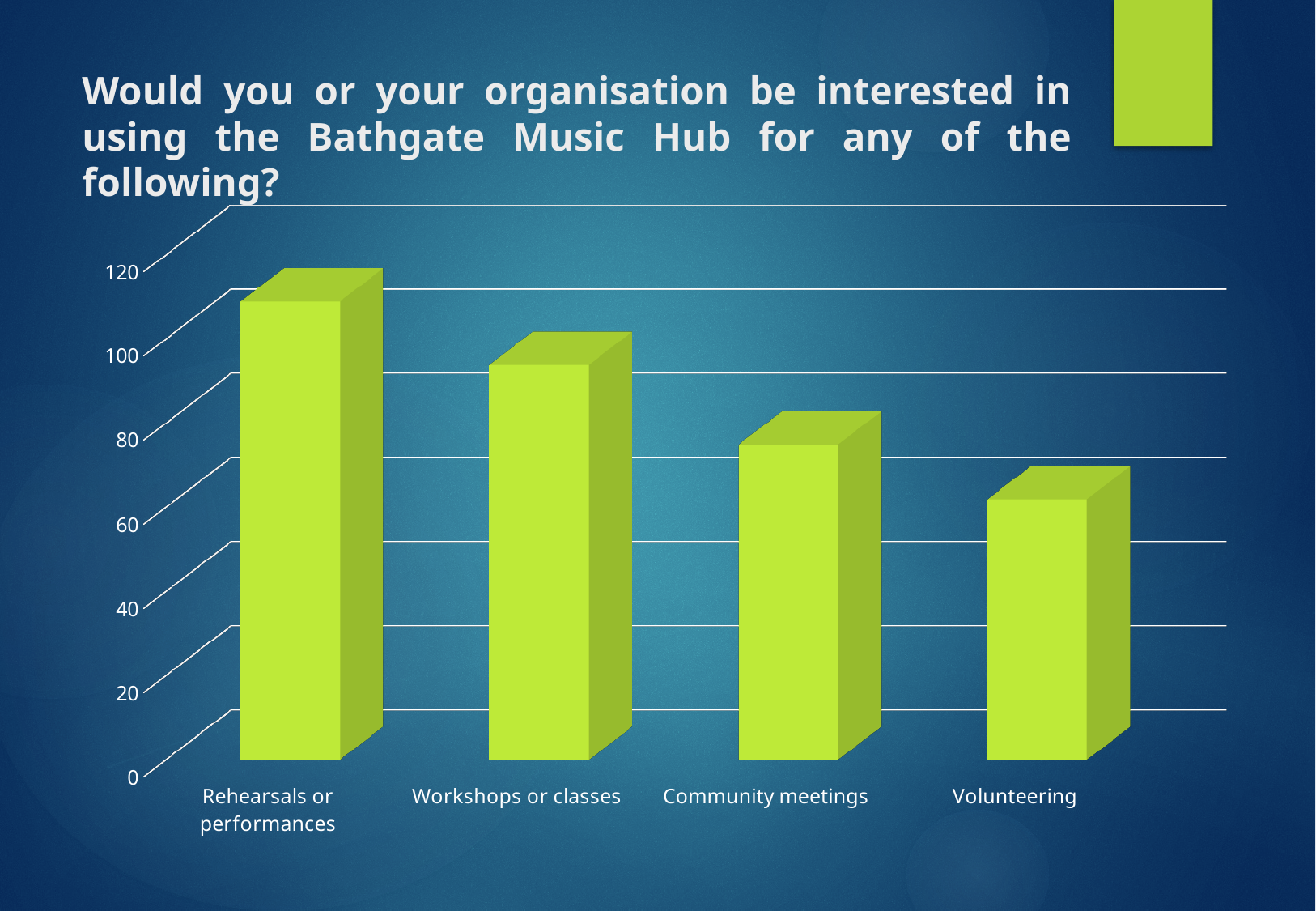
Is the value for Rehearsals or performances greater or less than 100? greater Which category has the lowest value? Volunteering Is the value for Community meetings greater or less than 100? less What is the title of the slide containing the chart? Would you or your organisation be interested in using the Bathgate Music Hub for any of the following? Is the value for Workshops or classes greater or less than 80? greater What kind of chart is shown on the slide? bar chart Which is larger, the value for Rehearsals or performances or the value for Volunteering? Rehearsals or performances How many categories are shown on the x axis of the chart? 4 Do the values rise or fall moving from left to right along the x axis? fall Which is larger, the value for Workshops or classes or the value for Community meetings? Workshops or classes Which category has the highest value? Rehearsals or performances